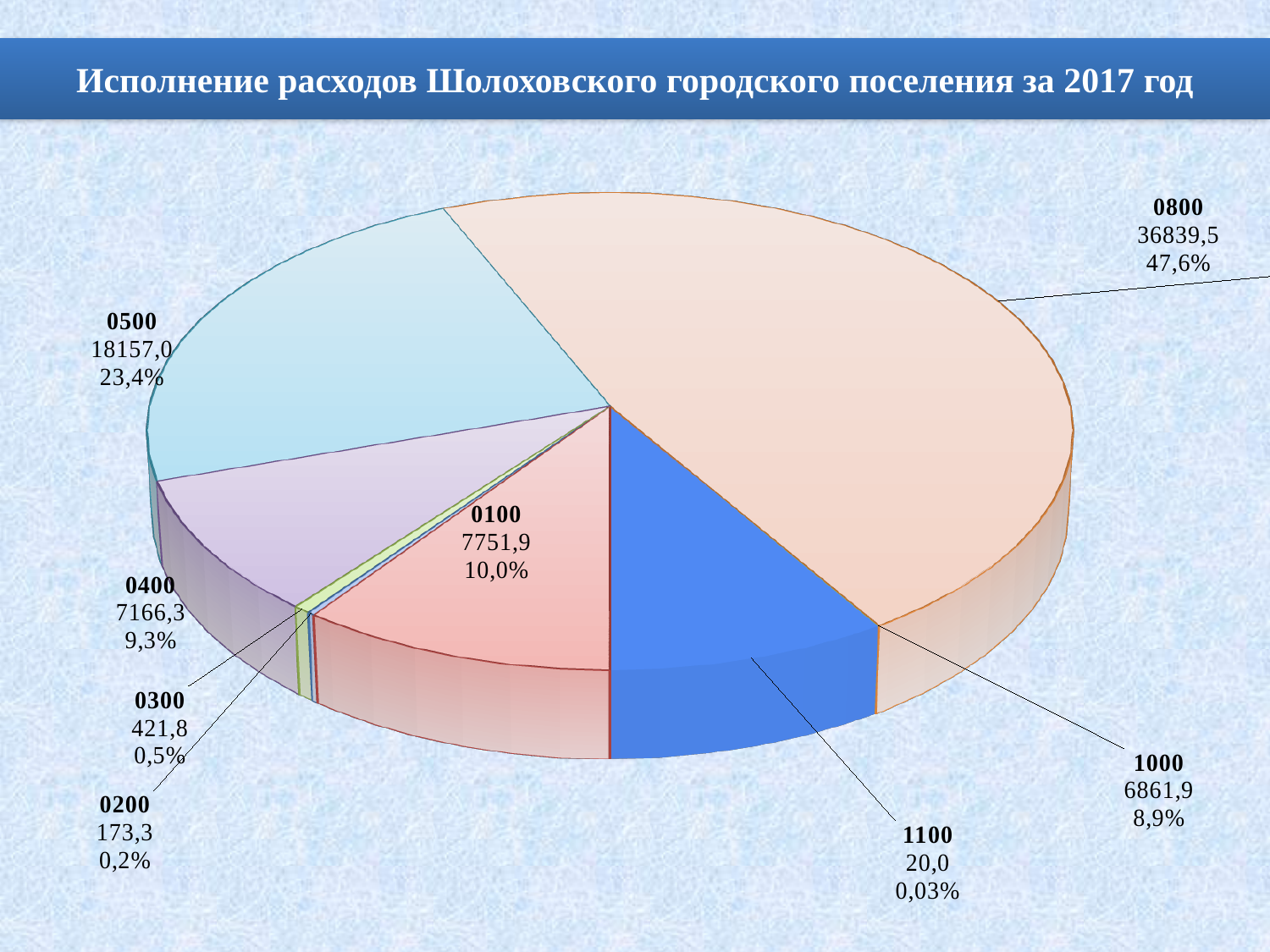
What is the title of the slide? Исполнение расходов Шолоховского городского поселения за 2017 год What percentage is shown for category 1000? 8,9% What type of chart is shown on the slide? pie chart Which category has the largest slice of the pie? 0800 What is the value shown for category 0100? 7751,9 Which is larger, the value for 0400 or the value for 1000? 0400 What percentage is shown for category 1100? 0,03% What share of the pie does category 0500 represent? 23,4% Which category has the smallest slice of the pie? 1100 What is the difference between the values for 0300 and 0200? 248,5 What is the value shown for category 0800? 36839,5